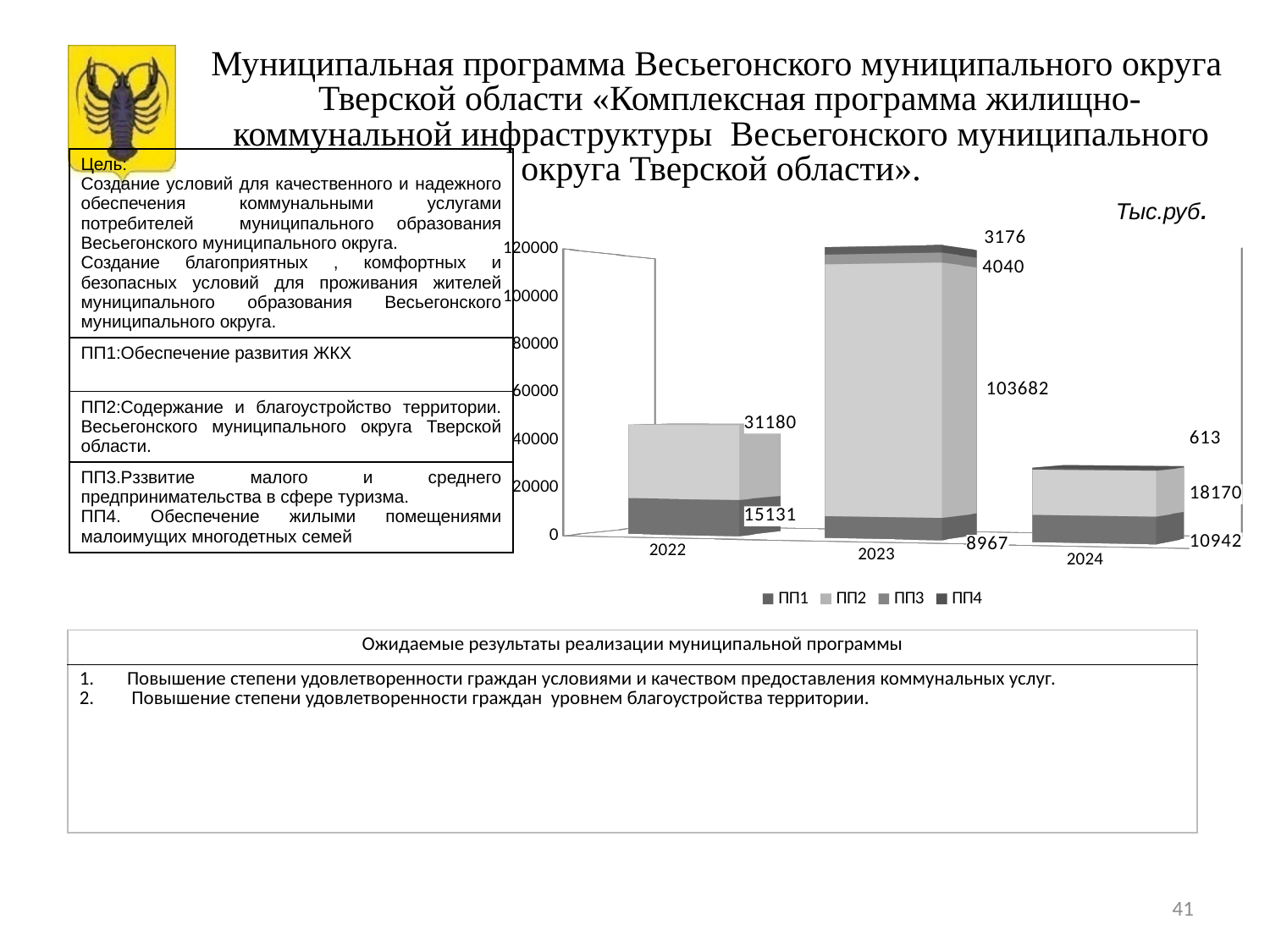
What is the value of ПП2 for 2023? 103682 What is the value of ПП2 for 2024? 18170 Which year has the tallest stacked bar? 2023 How many series does the legend list? 4 How many years are shown on the x axis? 3 What kind of chart is shown on the slide? Stacked bar chart Which year has the shortest stacked bar? 2024 Which is larger, the ПП1 value for 2022 or the ПП1 value for 2024? 2022 What is the difference between the ПП2 values for 2023 and 2022? 72502 What is the value of ПП1 for 2022? 15131 Is the total of the stacked bar for 2022 greater or less than 40000? greater What is the value of ПП4 for 2023? 3176